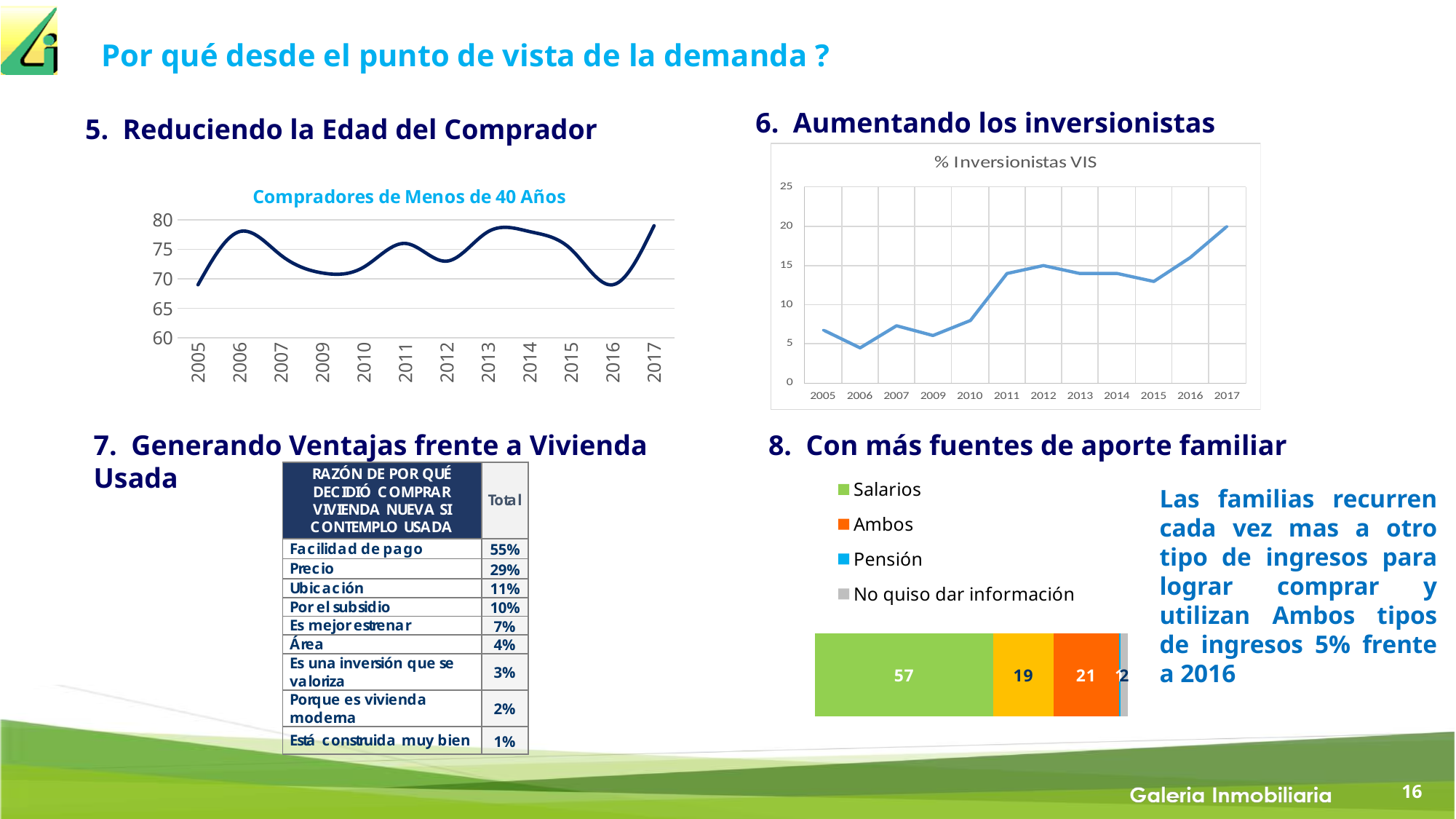
In the '% Inversionistas VIS' chart, is the value for 2005 greater or less than 10? less In the 'Compradores de Menos de 40 Años' chart, is the value for 2009 greater or less than 75? less How many years are plotted on the x axis of the 'Compradores de Menos de 40 Años' chart? 12 What kind of chart is 'Compradores de Menos de 40 Años'? line chart How many entries does the legend of the stacked bar chart under 'Con más fuentes de aporte familiar' list? 4 In the stacked bar chart under 'Con más fuentes de aporte familiar', what is the value for Salarios? 57 In the '% Inversionistas VIS' chart, which year has the lowest value? 2006 In the 'Compradores de Menos de 40 Años' chart, is the value for 2006 greater or less than 75? greater In the '% Inversionistas VIS' chart, do the values overall rise or fall from 2005 to 2017? rise In the '% Inversionistas VIS' chart, which year has the highest value? 2017 In the stacked bar chart under 'Con más fuentes de aporte familiar', which is larger, Salarios or Ambos? Salarios